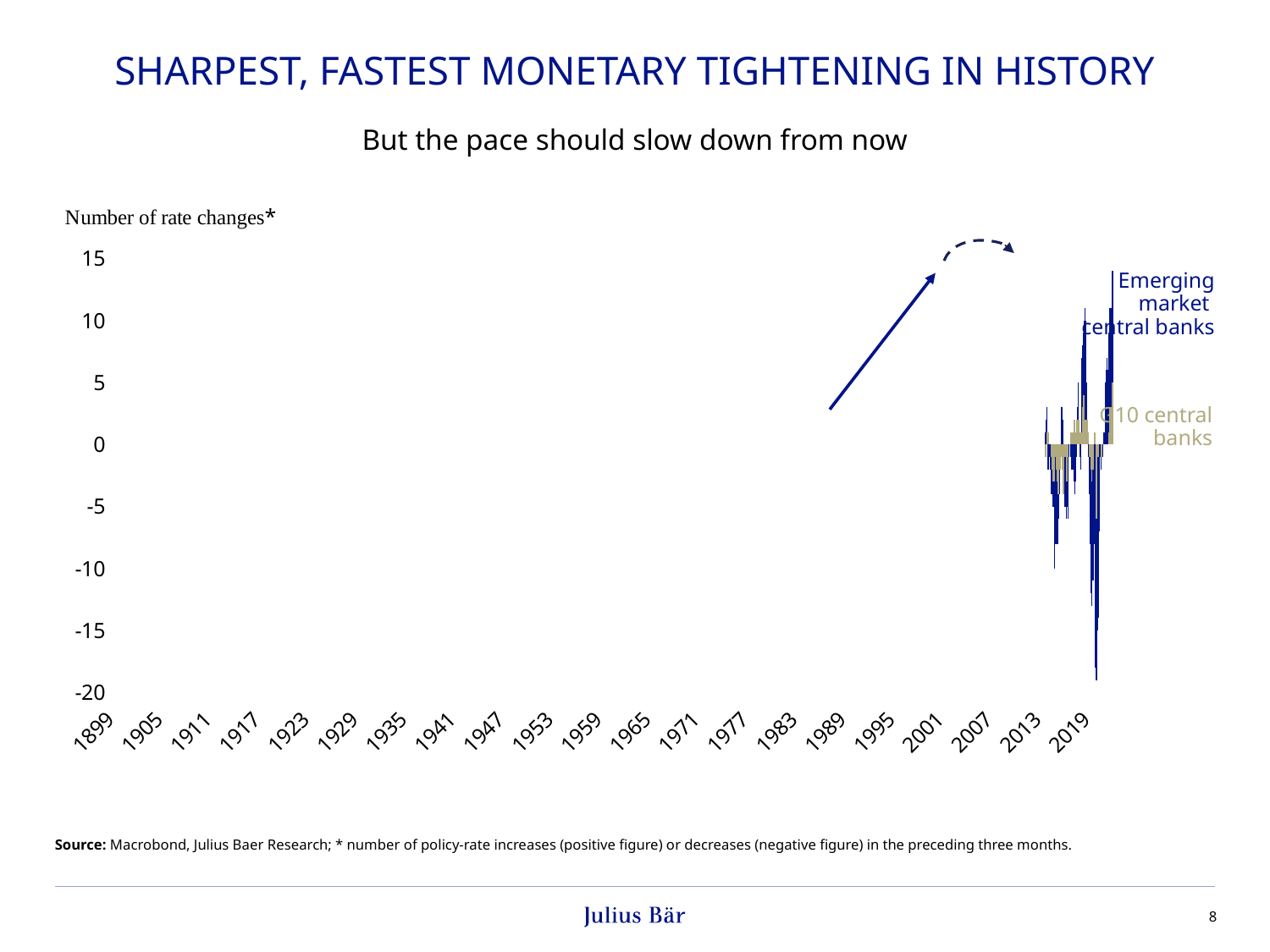
What is the highest value shown on the vertical axis of the chart? 15 What is the last year label on the horizontal axis? 2019 What is the lowest value shown on the vertical axis of the chart? -20 What is the first year label on the horizontal axis? 1899 How many series are plotted on the chart? 2 How many year labels are shown on the horizontal axis? 21 Which series reaches a higher peak value, Emerging market central banks or G10 central banks? Emerging market central banks Which series on the chart is drawn in blue? Emerging market central banks